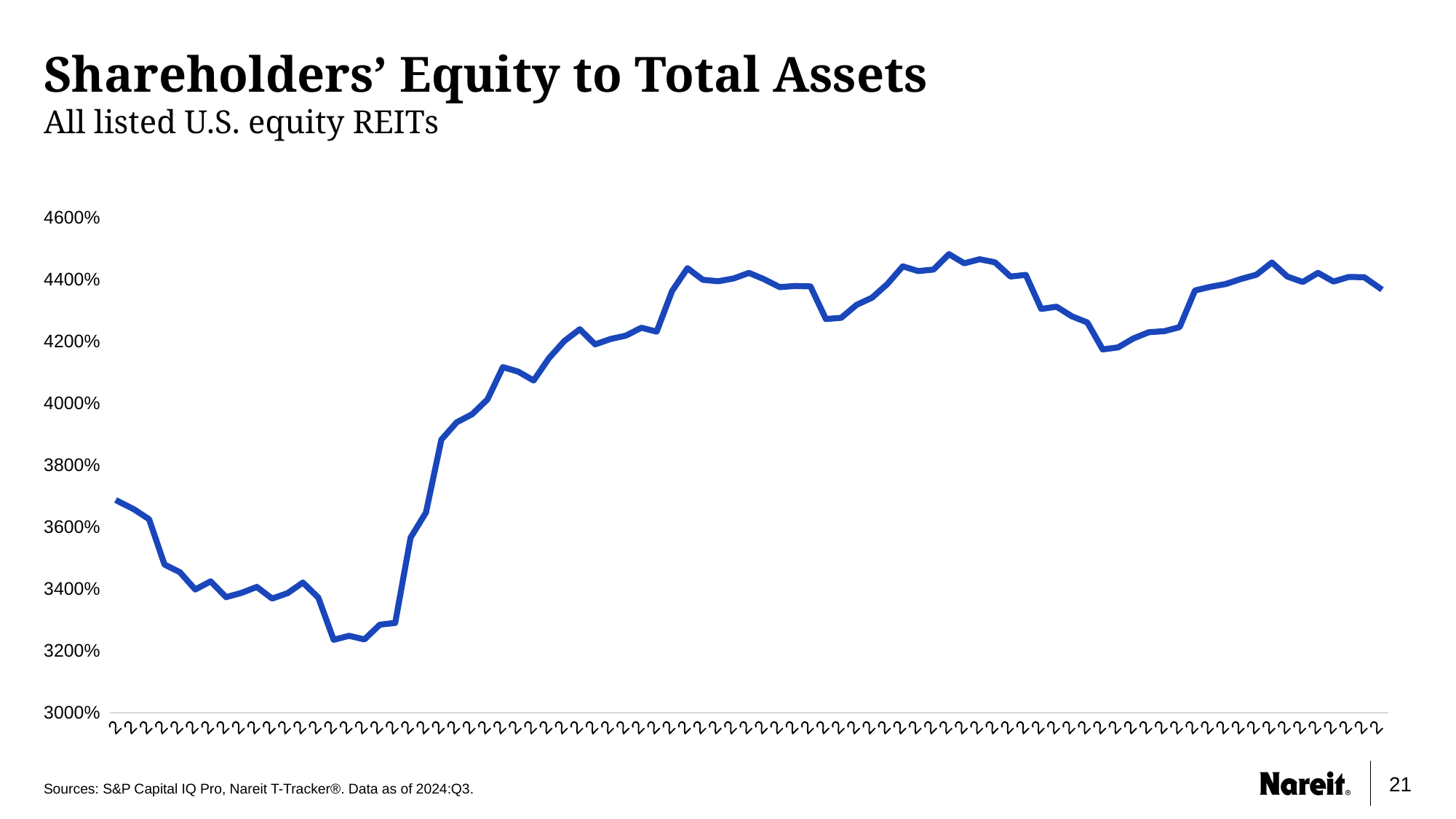
Is the value at the last point of the line greater or less than 4400%? less Which is larger, the value at the first point of the line or the value at the last point? The last point Overall, does the line rise or fall from the first point to the last point along the x axis? Rise Is the highest point on the line greater or less than 4600%? less Is the value at the first point of the line greater or less than 3600%? greater How many lines (series) are plotted on the chart? 1 What is the title of the chart on the slide? Shareholders' Equity to Total Assets What kind of chart is shown on the slide? Line chart Which group of REITs does the subtitle say the chart covers? All listed U.S. equity REITs